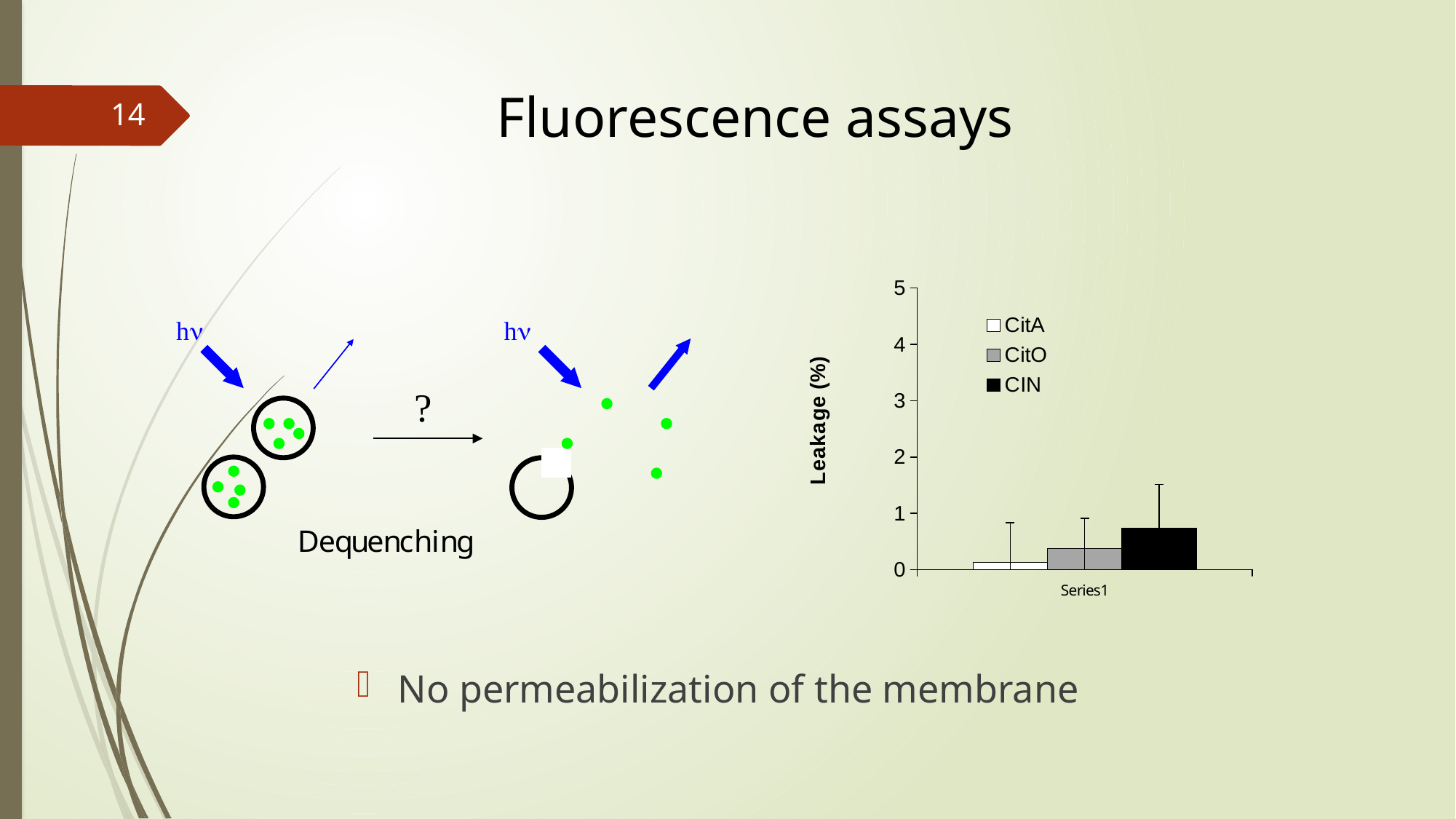
What is the label of the chart's y axis? Leakage (%) How many categories are shown on the x axis of the chart? 1 Which series has the highest leakage value in the chart? CIN Which has a larger leakage value, CitO or CIN? CIN Is the leakage value for CitA greater or less than 1? less Which has a larger leakage value, CitA or CitO? CitO Which series is shown with black bars in the chart? CIN Is the leakage value for CIN greater or less than 1? less Is the leakage value for CitO greater or less than 2? less What kind of chart is shown on the slide? bar chart How many series does the chart's legend list? 3 Which series has the lowest leakage value in the chart? CitA